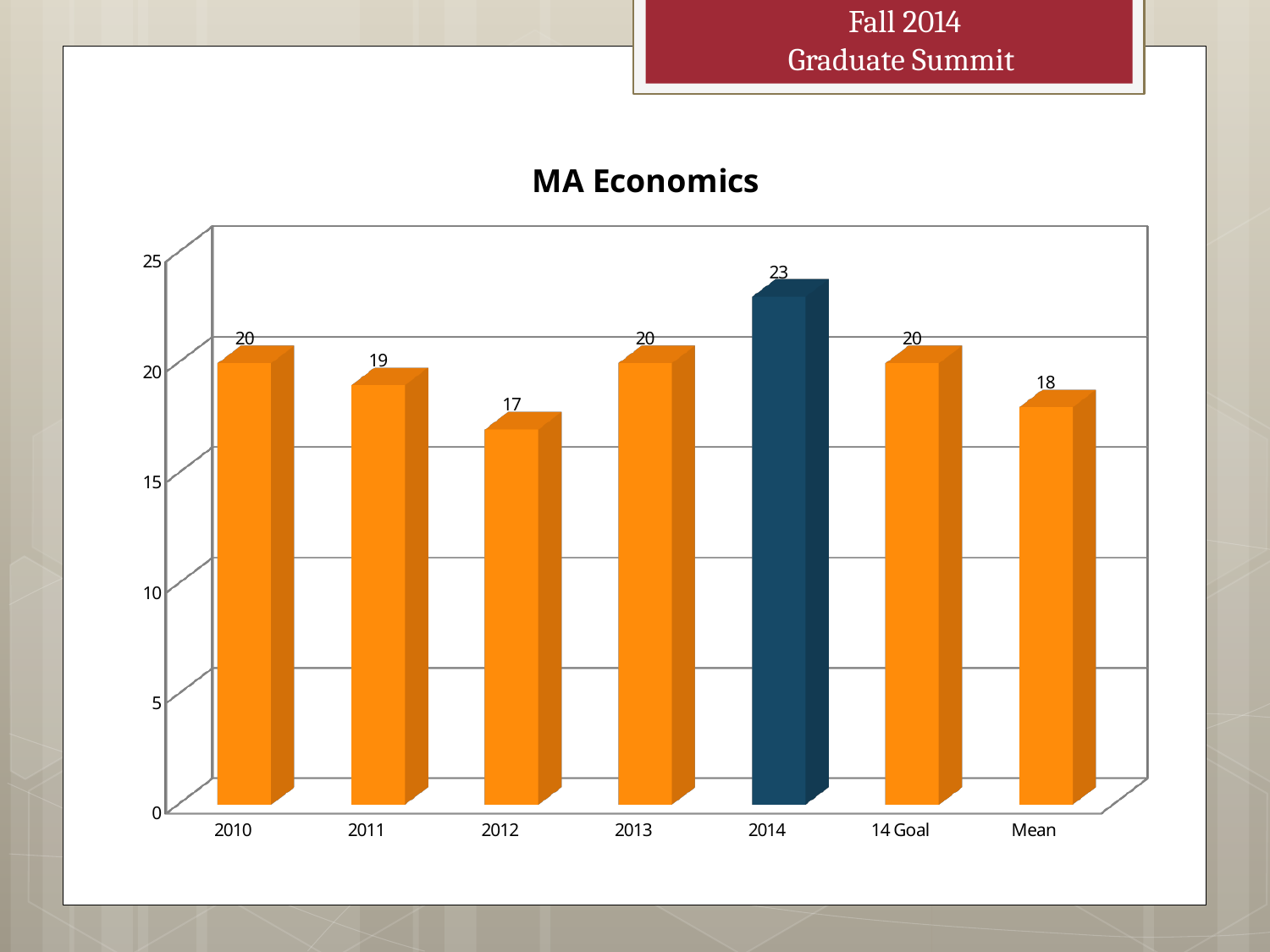
What is the value for the Mean bar in the MA Economics chart? 18 Which bar in the MA Economics chart is coloured differently from the others? 2014 What kind of chart is shown on the slide? Bar chart Is the value for 2014 in the MA Economics chart greater or less than 20? greater How many bars are shown in the MA Economics chart? 7 Which category has the lowest value in the MA Economics chart? 2012 Which category has the highest value in the MA Economics chart? 2014 What is the value for 14 Goal in the MA Economics chart? 20 What is the value for 2012 in the MA Economics chart? 17 Which is larger in the MA Economics chart, the value for 2011 or the value for 2012? 2011 What is the value for 2014 in the MA Economics chart? 23 What is the difference between the 2014 value and the 14 Goal value in the MA Economics chart? 3